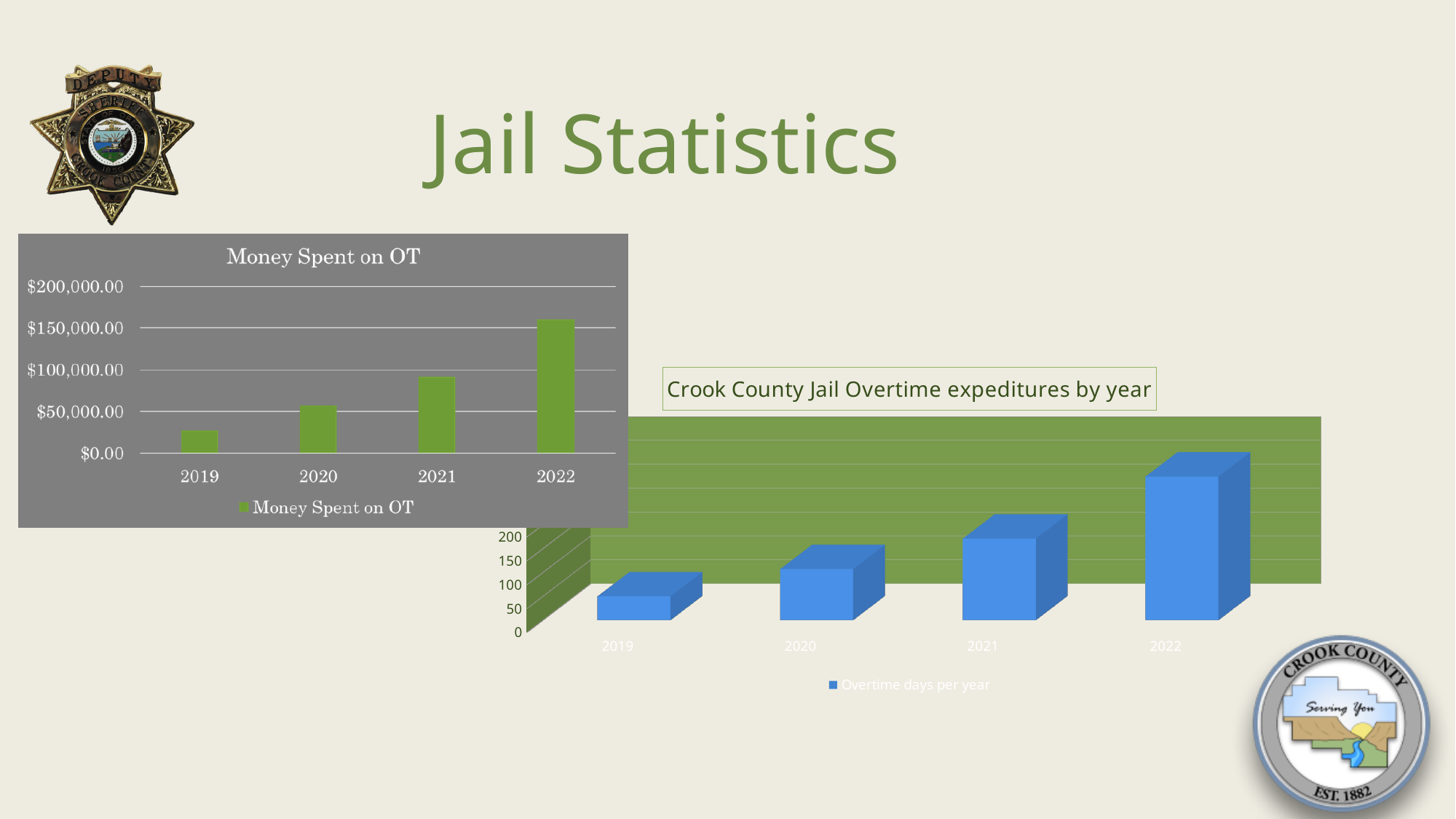
How many years are shown in the "Money Spent on OT" chart? 4 In the "Crook County Jail Overtime expeditures by year" chart, which year has the lowest value? 2019 In the "Money Spent on OT" chart, is the value for 2021 greater or less than $100,000.00? less In the "Money Spent on OT" chart, is the value for 2019 greater or less than $50,000.00? less In the "Money Spent on OT" chart, which year has the highest value? 2022 In the "Money Spent on OT" chart, is the value for 2022 greater or less than $150,000.00? greater What series does the legend of the "Crook County Jail Overtime expeditures by year" chart list? Overtime days per year In the "Crook County Jail Overtime expeditures by year" chart, which year has the highest value? 2022 In the "Money Spent on OT" chart, which year has the lowest value? 2019 In the "Money Spent on OT" chart, do the values rise or fall from 2019 to 2022? rise What type of chart is the "Money Spent on OT" chart? bar chart